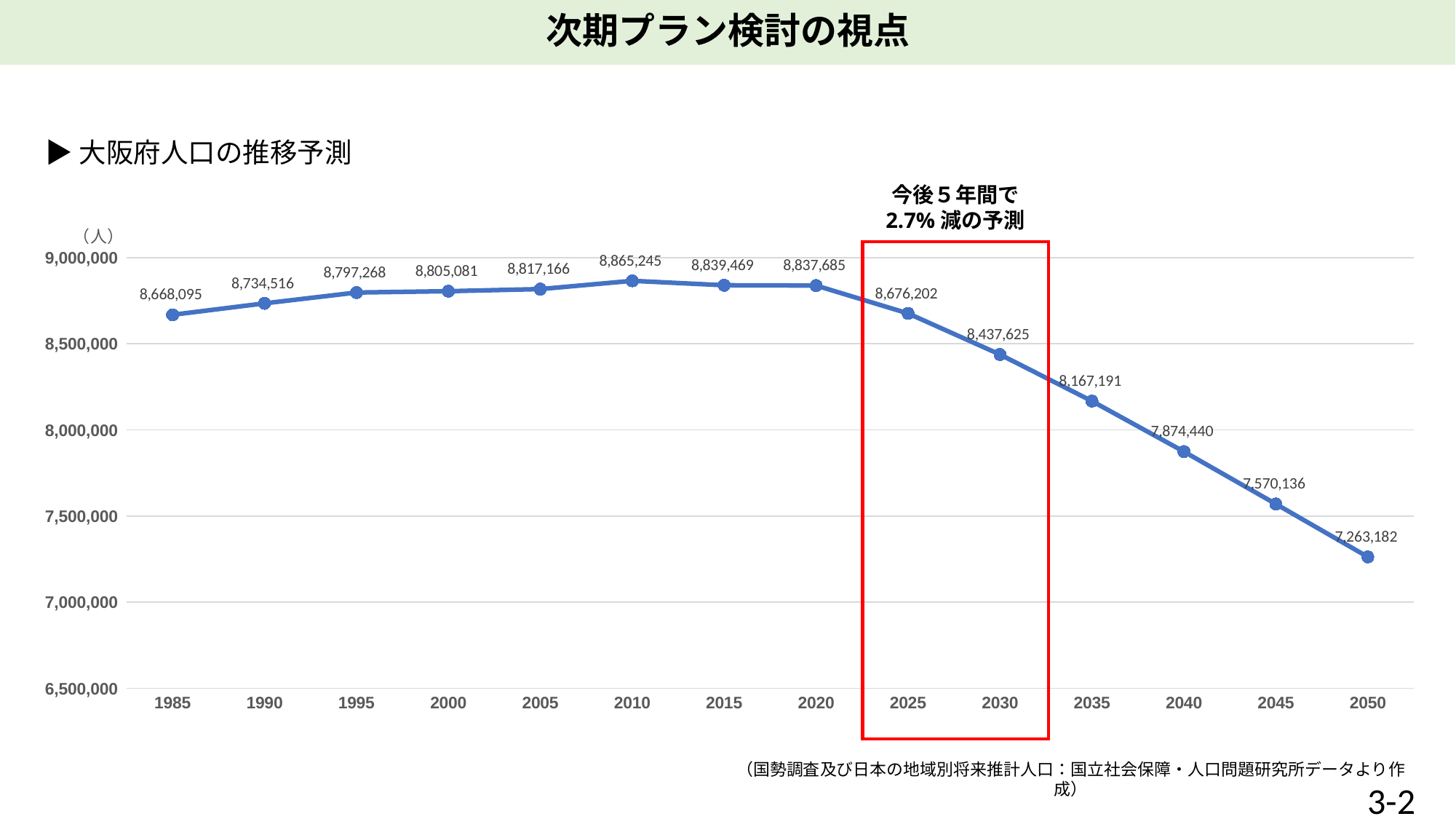
Is the value for 2040 greater or less than 8,000,000? less What is the projected population of Osaka Prefecture in 2050? 7,263,182 In which year is the population lowest? 2050 What kind of chart is shown on the slide? line chart In which year is the population highest? 2010 Which year has the larger population, 2000 or 2015? 2015 Do the values rise or fall from 2020 to 2050? fall What is the difference between the 2020 and 2050 population values? 1,574,503 What is the population value shown for 1985? 8,668,095 What is the population value shown for 2030? 8,437,625 What is the difference between the 2025 and 2030 population values? 238,577 How many data points are plotted on the chart? 14